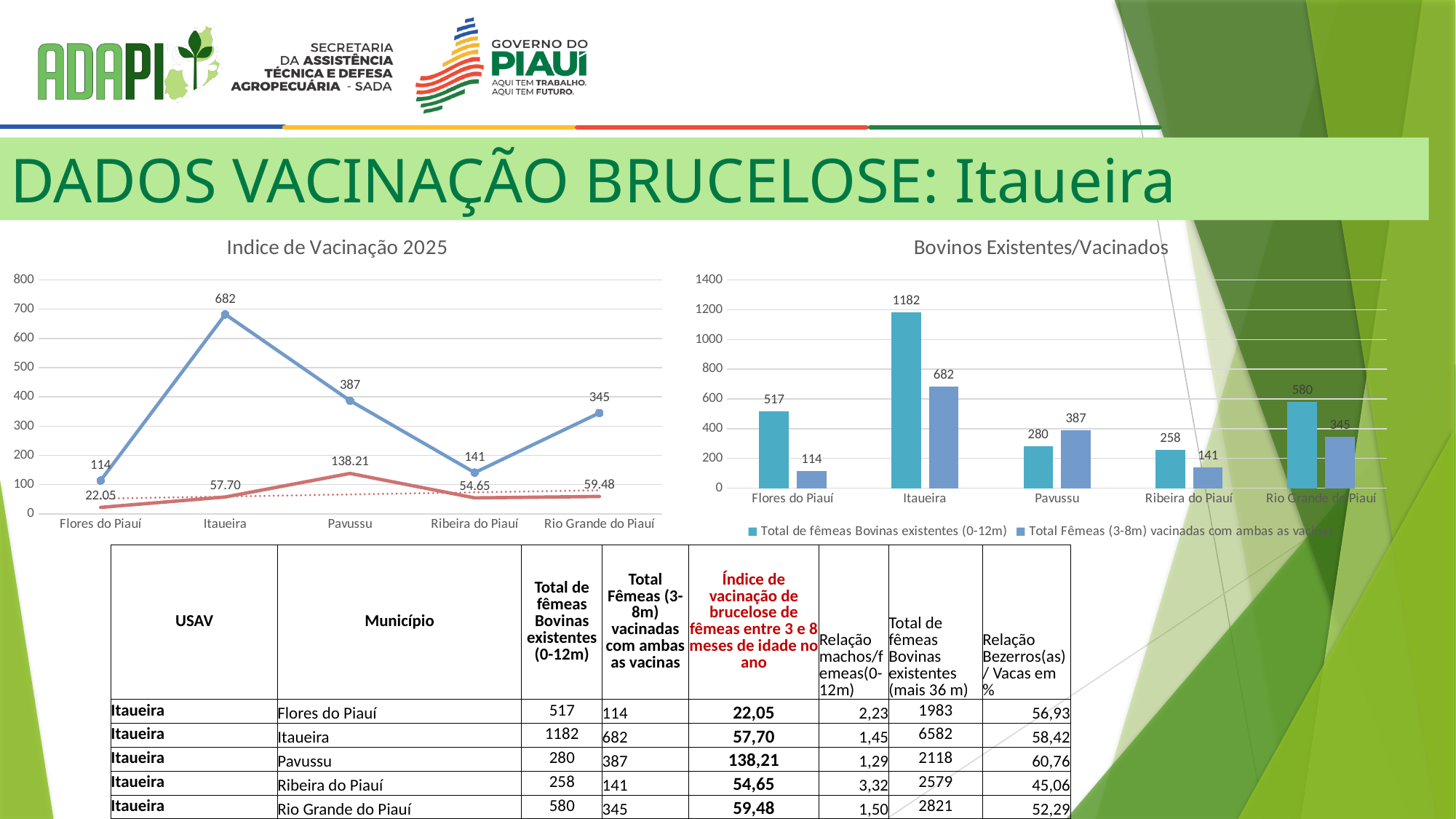
In the 'Bovinos Existentes/Vacinados' chart, for Pavussu, which is larger: the existing females (0-12m) or the vaccinated females (3-8m)? Vaccinated females (3-8m) How many series does the legend of the 'Bovinos Existentes/Vacinados' chart list? 2 What kind of chart is 'Indice de Vacinação 2025'? Line chart In the 'Indice de Vacinação 2025' chart, what is the value of the red line for Pavussu? 138.21 In the 'Indice de Vacinação 2025' chart, does the blue line rise or fall from Itaueira to Ribeira do Piauí? Fall How many municipalities are shown on the x axis of the 'Indice de Vacinação 2025' chart? 5 In the 'Indice de Vacinação 2025' chart, at which municipality does the blue line reach its highest value? Itaueira In the 'Bovinos Existentes/Vacinados' chart, what is the value of 'Total de fêmeas Bovinas existentes (0-12m)' for Itaueira? 1182 In the 'Bovinos Existentes/Vacinados' chart, is the value of existing females (0-12m) for Rio Grande do Piauí greater or less than 400? greater In the 'Bovinos Existentes/Vacinados' chart, what is the difference between the existing females (0-12m) and the vaccinated females (3-8m) for Flores do Piauí? 403 What kind of chart is 'Bovinos Existentes/Vacinados'? Bar chart In the 'Bovinos Existentes/Vacinados' chart, which municipality has the highest value for 'Total Fêmeas (3-8m) vacinadas com ambas as vacinas'? Itaueira